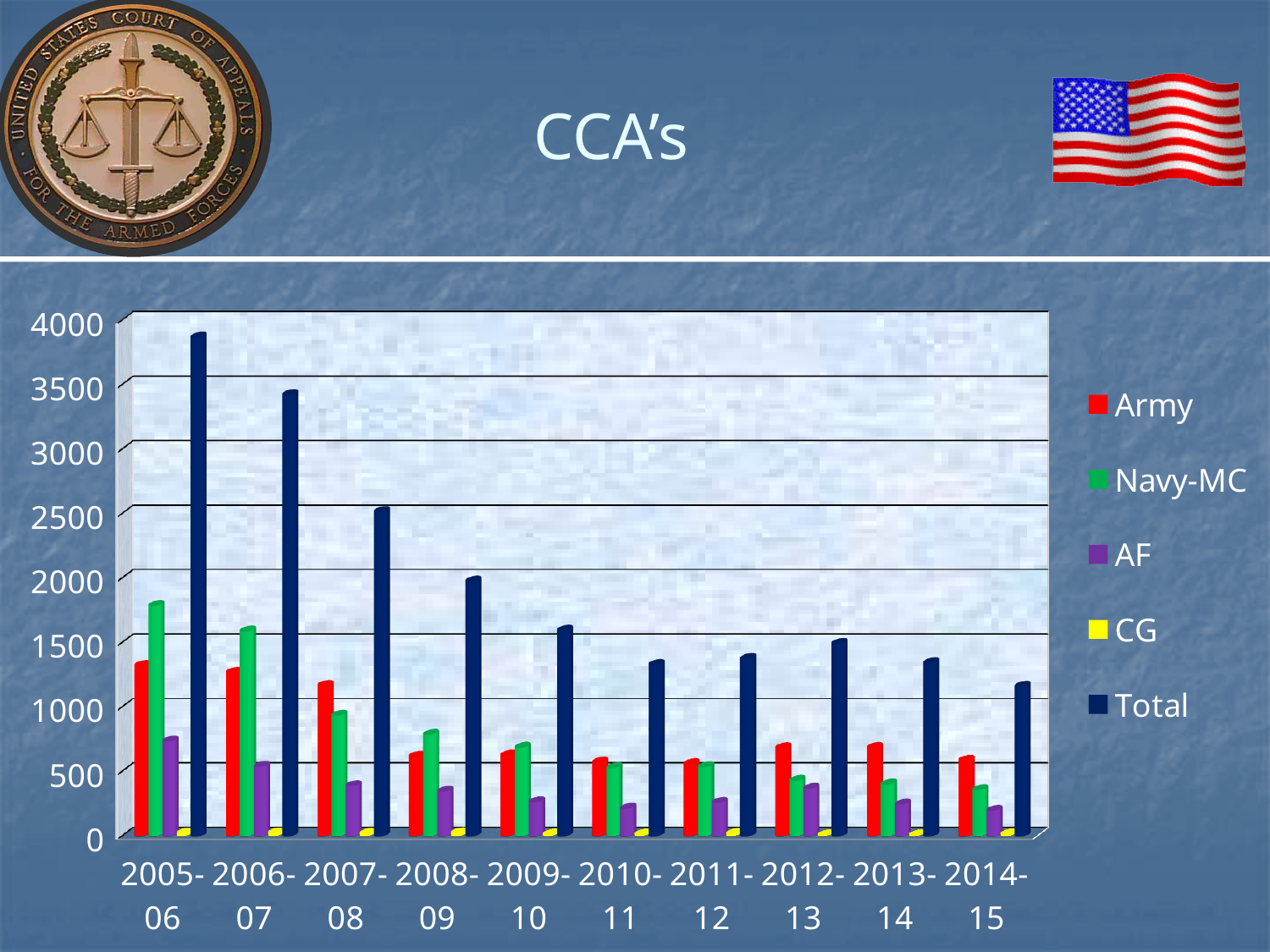
In 2005-06, which is larger, the Army value or the Navy-MC value? Navy-MC Is the Army value for 2007-08 greater or less than 1000? greater What kind of chart is shown on the slide? bar chart What is the title of the chart slide? CCA's How many year categories are shown on the x axis? 10 In 2014-15, which is larger, the Army value or the Navy-MC value? Army Is the Navy-MC value for 2005-06 greater or less than 1500? greater Does the Total value generally rise or fall from 2005-06 to 2014-15? fall In which year is the Navy-MC value highest? 2005-06 Is the Total value for 2005-06 greater or less than 3500? greater In which year is the Total value highest? 2005-06 How many series does the legend list? 5